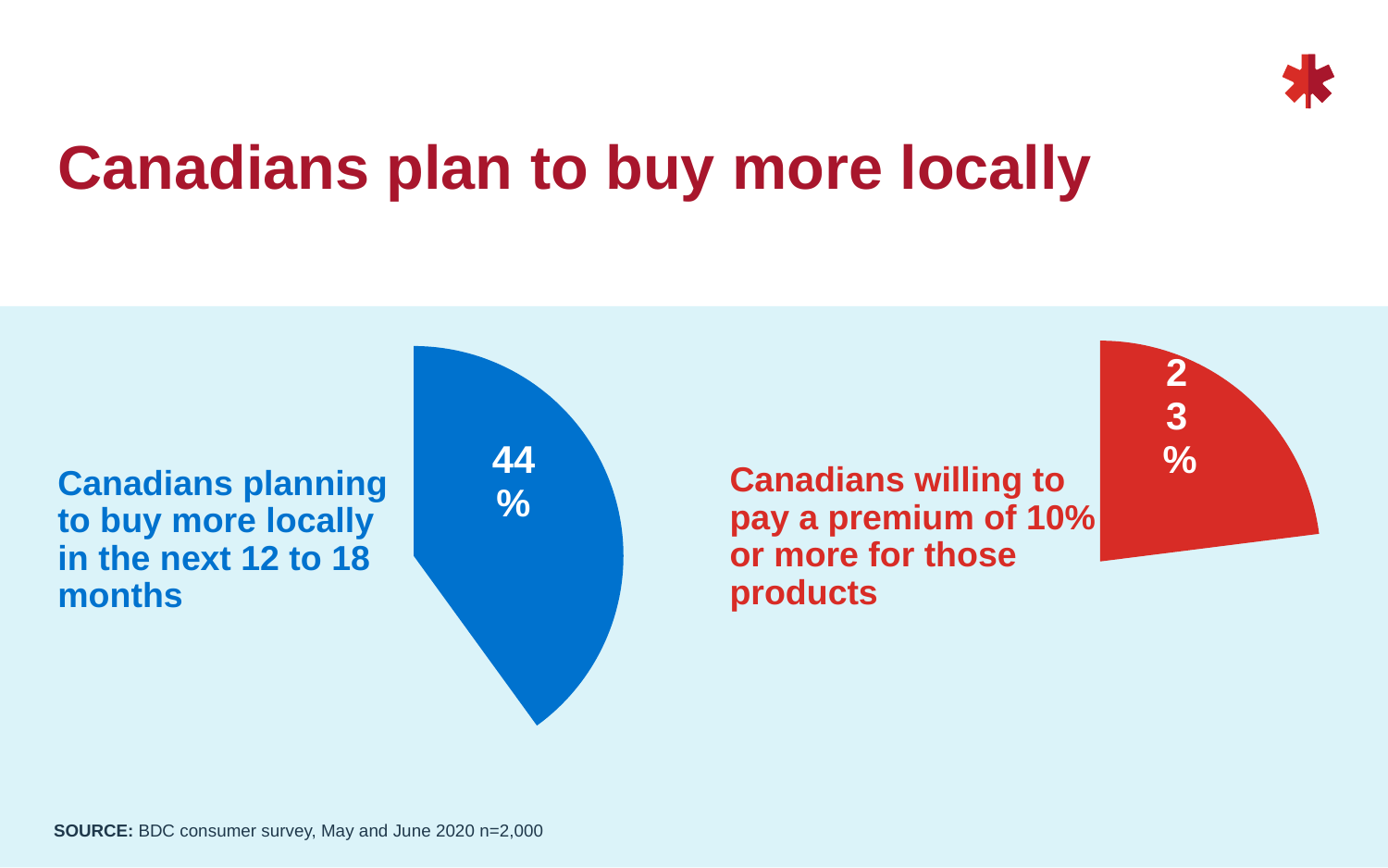
Is the value on the right chart (Canadians willing to pay a premium of 10% or more) greater or less than 50%? less What kind of chart is used on the left side of the slide to show the 44% value? Pie chart What kind of chart is used on the right side of the slide to show the 23% value? Pie chart On the right chart, what percentage of Canadians are willing to pay a premium of 10% or more for those products? 23% On the left chart, what percentage of Canadians are planning to buy more locally in the next 12 to 18 months? 44% What is the difference in percentage points between the value on the left chart (44%) and the value on the right chart (23%)? 21 percentage points Is the value on the left chart (Canadians planning to buy more locally) greater or less than 50%? less How many charts are shown on the slide? 2 What colour is the slice on the left chart showing 44%? Blue Which is larger: the share of Canadians planning to buy more locally (left chart) or the share willing to pay a premium of 10% or more (right chart)? Canadians planning to buy more locally What colour is the slice on the right chart showing 23%? Red